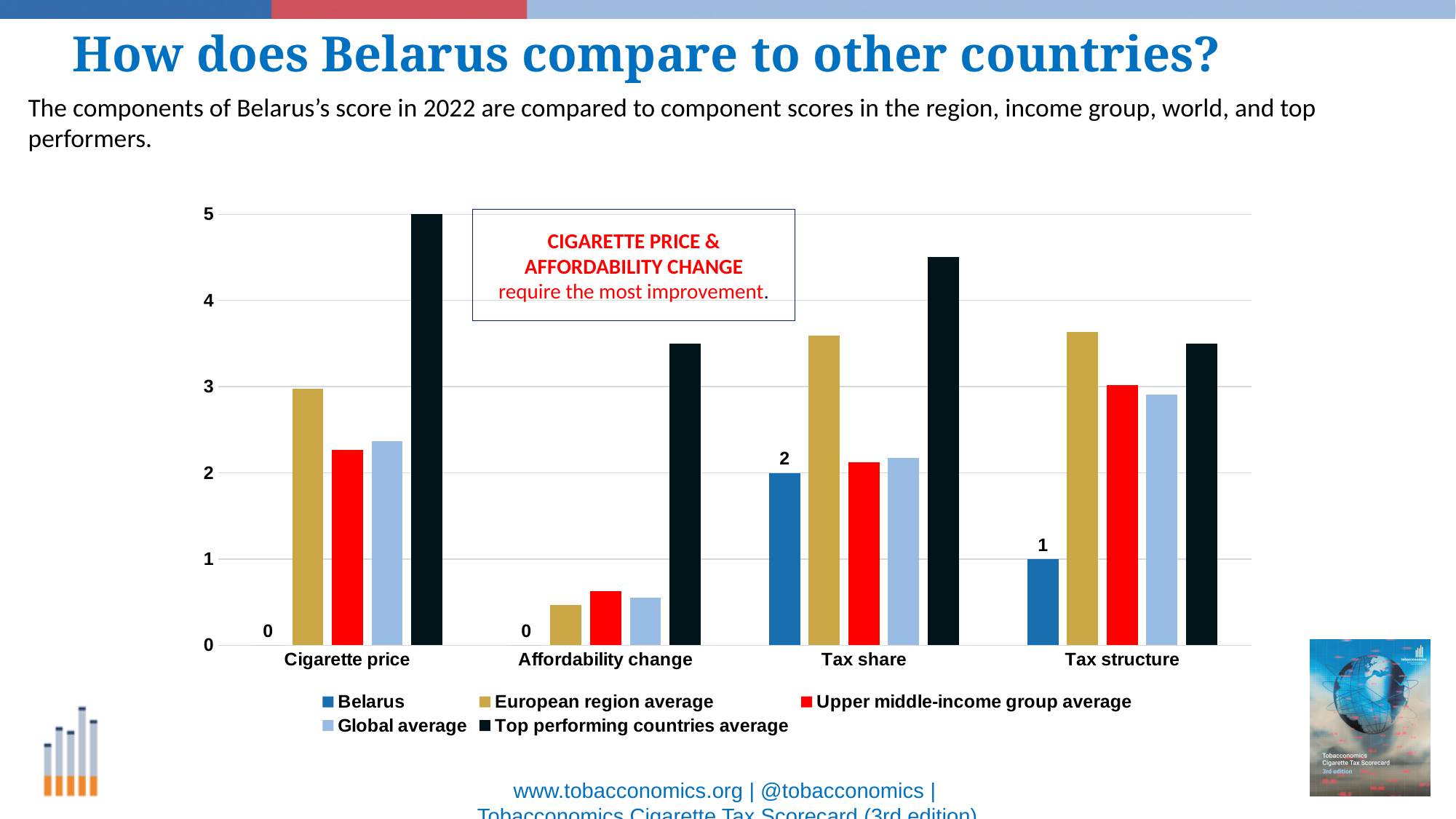
How many series does the legend list? 5 How many categories are shown on the x axis of the chart? 4 What is the value for Belarus in the Tax share category? 2 In which category does Belarus have its highest value? Tax share What is the value for Belarus in the Cigarette price category? 0 Which is larger in the Cigarette price category: the Top performing countries average or the European region average? Top performing countries average What is the value for Belarus in the Tax structure category? 1 What kind of chart is shown on the slide? bar chart Is the value for Top performing countries average in the Affordability change category greater or less than 3? greater What is the difference between the Belarus values for Tax share and Tax structure? 1 Which two components does the text box on the chart say require the most improvement? Cigarette price & Affordability change What is the value for Top performing countries average in the Cigarette price category? 5